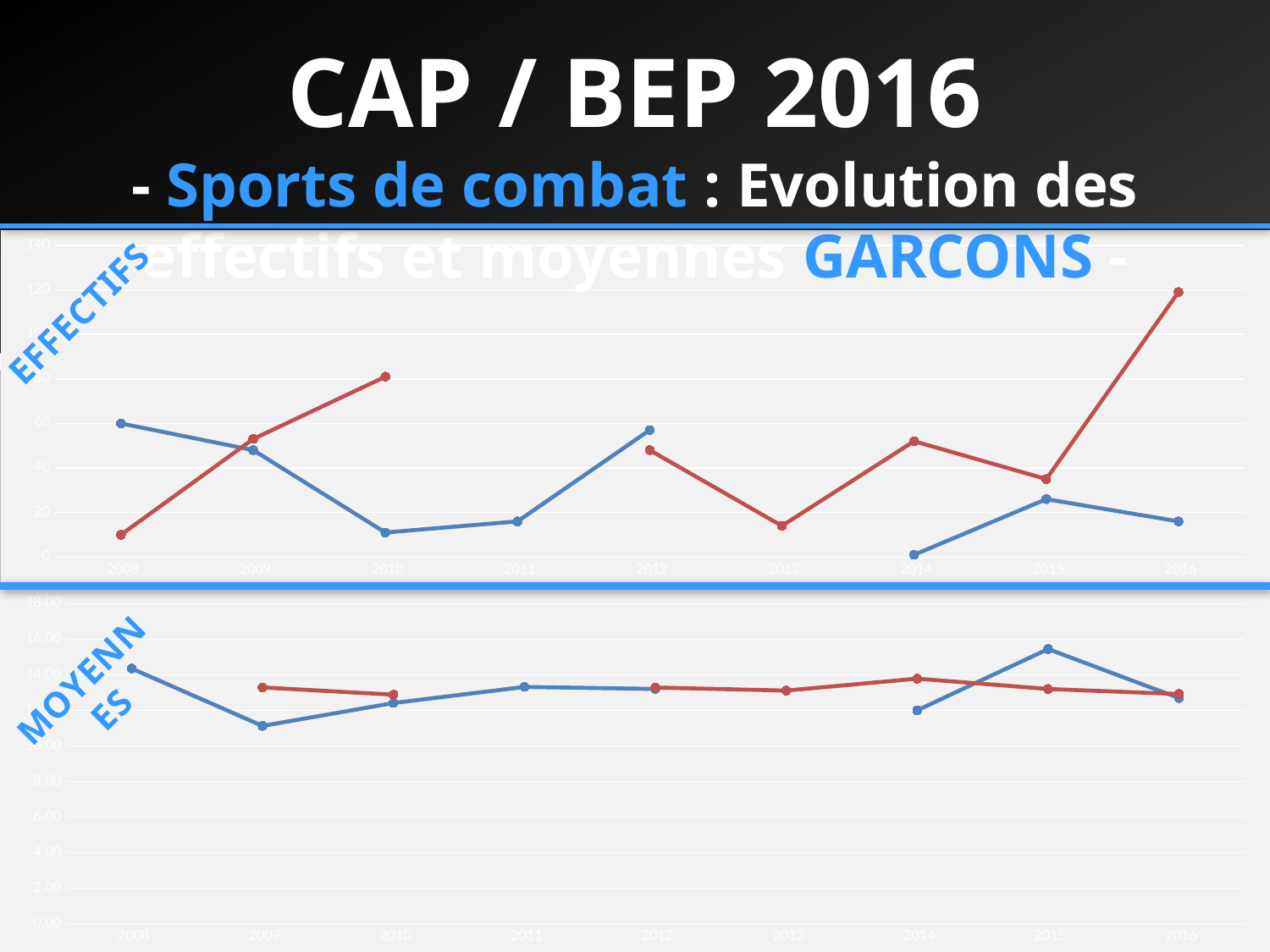
How many years are shown on the x axis of the top chart (EFFECTIFS)? 9 What kind of chart is the top chart (EFFECTIFS)? line chart In the top chart (EFFECTIFS), does the red line rise or fall between 2015 and 2016? rise In the top chart (EFFECTIFS), is the blue line's value for 2010 greater or less than 20? less In the top chart (EFFECTIFS), is the red line's value for 2016 greater or less than 100? greater In the top chart (EFFECTIFS), is the red line's value for 2010 greater or less than 60? greater In the top chart (EFFECTIFS), which line has the larger value in 2008, the blue line or the red line? the blue line In the top chart (EFFECTIFS), in which year does the red line reach its highest value? 2016 What kind of chart is the bottom chart (MOYENNES)? line chart In the bottom chart (MOYENNES), in which year does the blue line reach its highest value? 2015 In the top chart (EFFECTIFS), which line has the larger value in 2014, the blue line or the red line? the red line